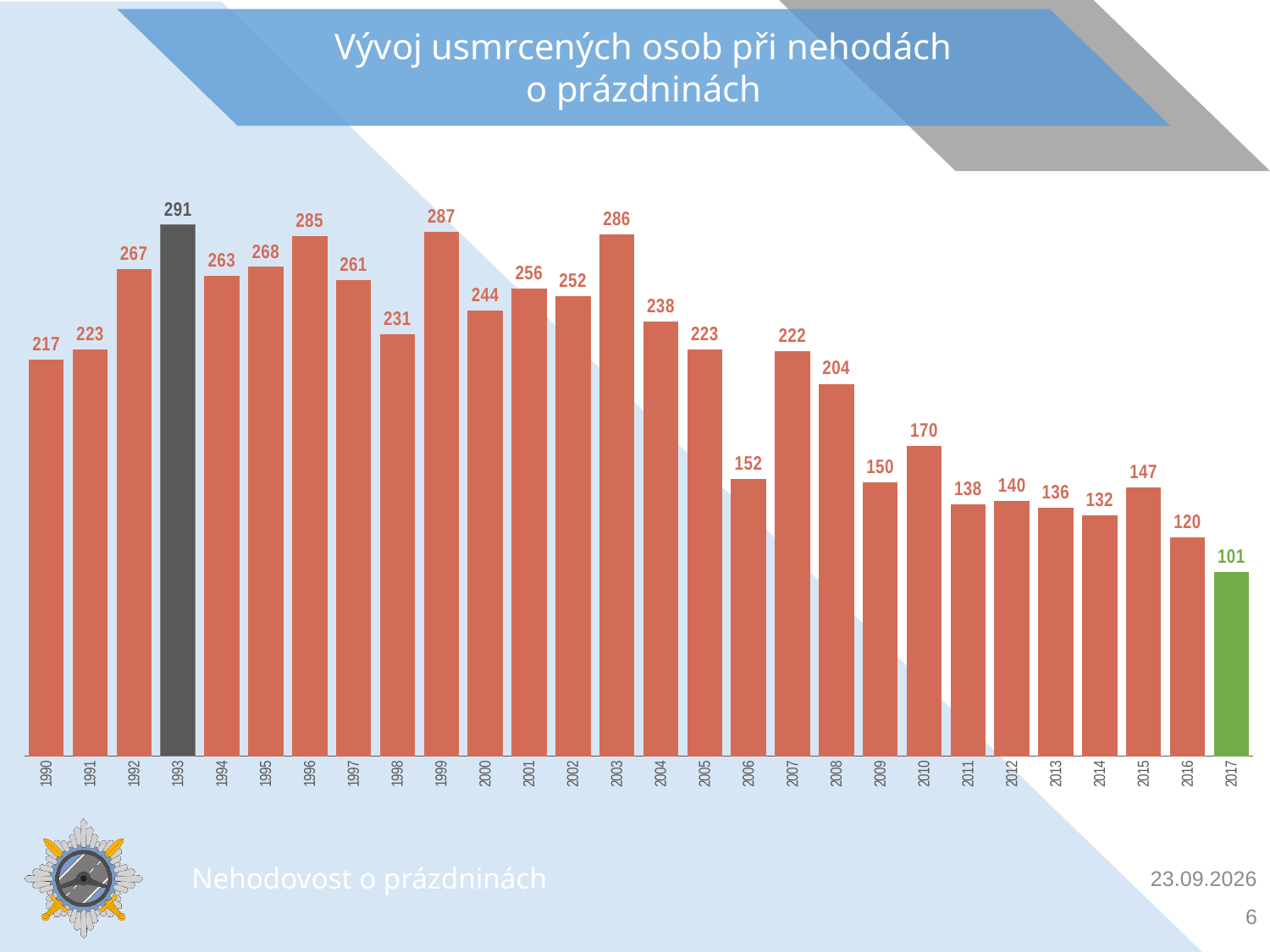
What is the title of the chart? Vývoj usmrcených osob při nehodách o prázdninách What is the difference between the values for 1993 and 2017? 190 How many years are shown on the chart? 28 Which is larger, the value for 2006 or the value for 2010? 2010 What kind of chart is shown on the slide? bar chart Which year has the lowest value? 2017 Which is larger, the value for 1996 or the value for 1999? 1999 What is the value for 1993? 291 What is the difference between the values for 2015 and 2016? 27 What is the value for 2017? 101 Which year has the highest value? 1993 What is the value for 2003? 286